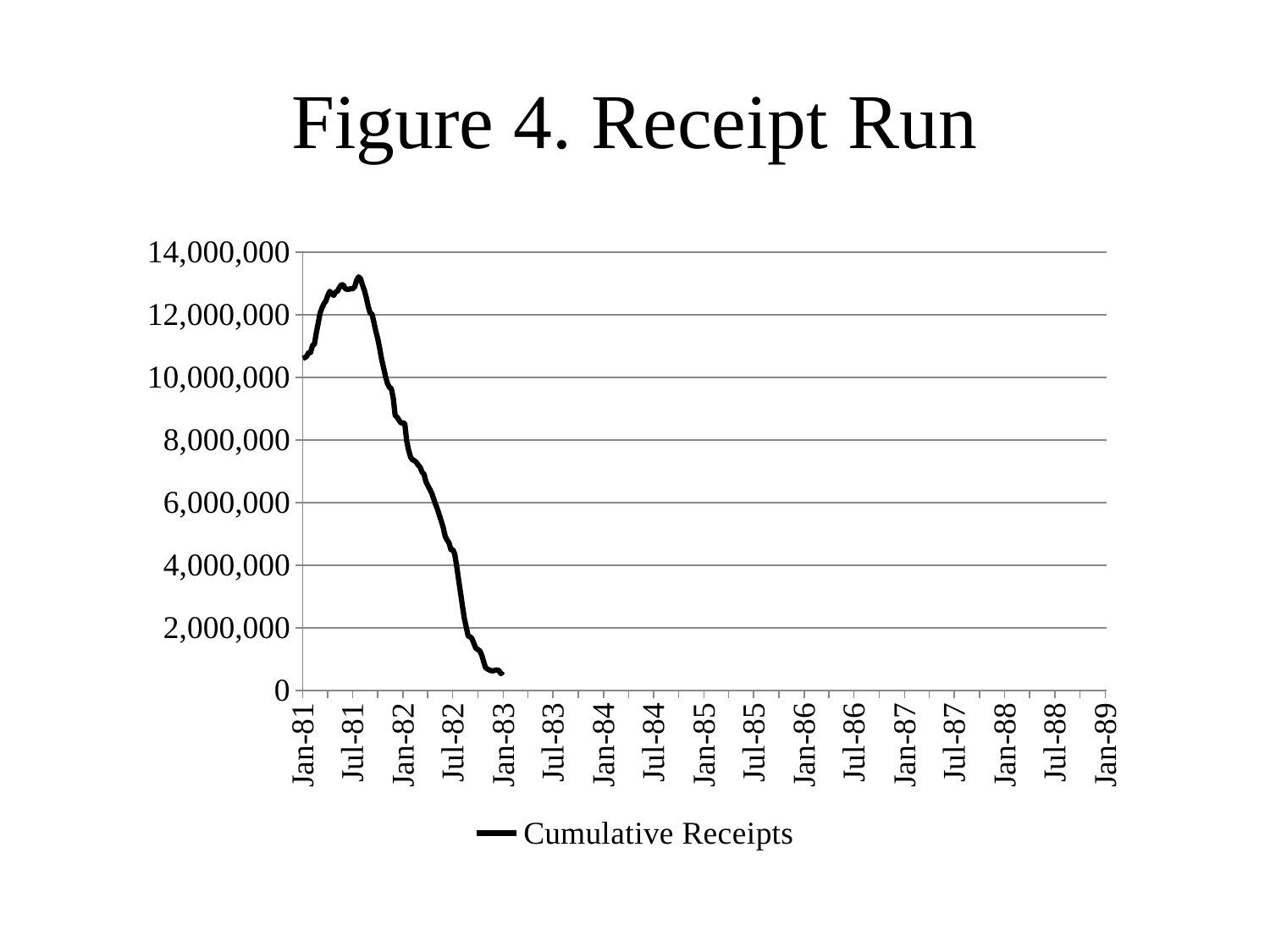
Is the value for Cumulative Receipts at Jan-81 greater or less than 10,000,000? greater Is the value for Cumulative Receipts at Jan-83 greater or less than 2,000,000? less Is the value for Cumulative Receipts at Jul-81 greater or less than 12,000,000? greater How many labels are shown on the x axis? 17 What kind of chart is shown on the slide? line chart What series name appears in the legend? Cumulative Receipts Do the Cumulative Receipts values rise or fall between Jul-81 and Jan-83? fall What is the title of the chart? Figure 4. Receipt Run Which is larger, the Cumulative Receipts value at Jan-81 or at Jan-83? Jan-81 How many series does the legend list? 1